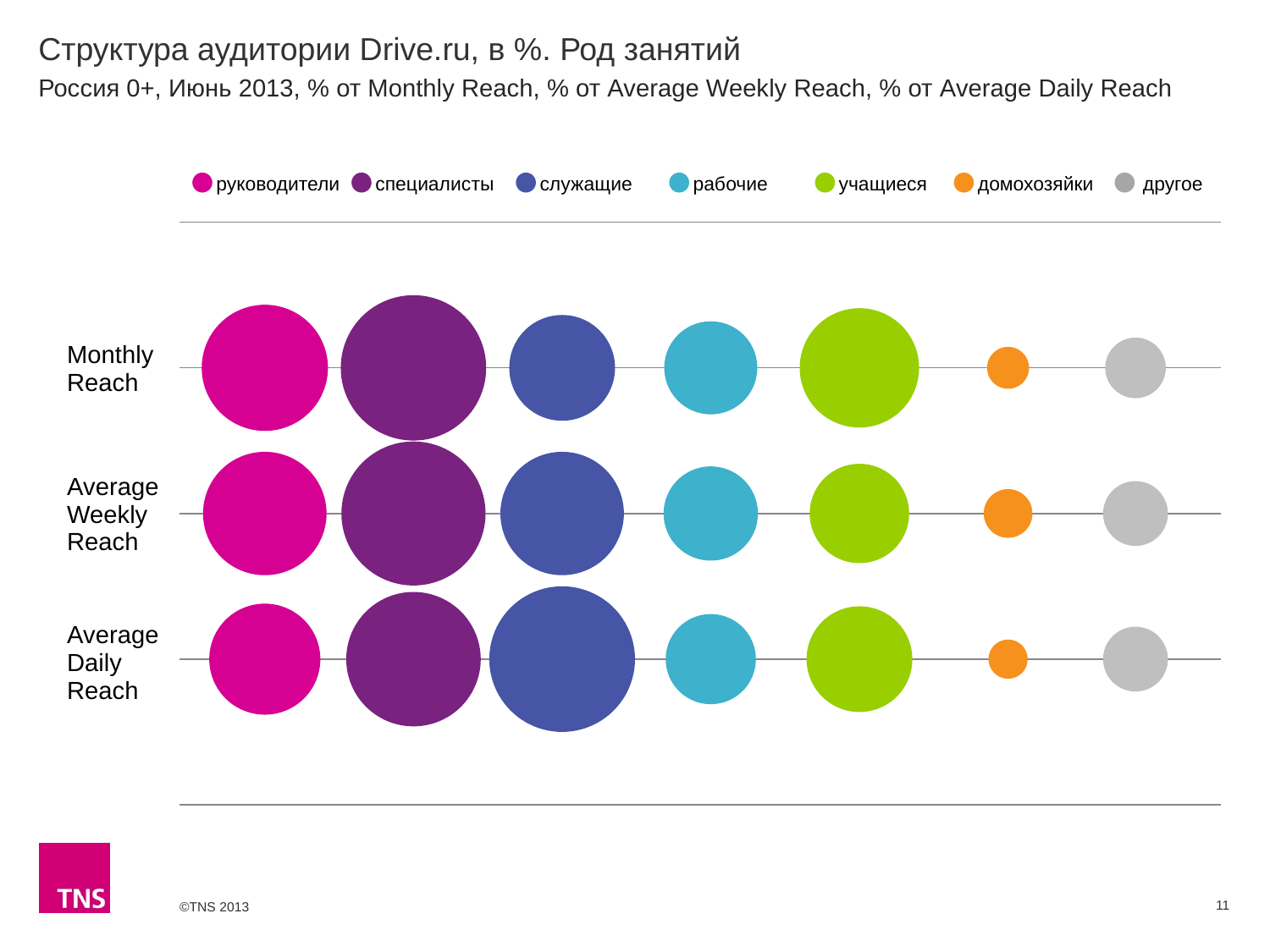
In the Average Daily Reach row, which occupation group has the smallest bubble? домохозяйки In the Monthly Reach row, which occupation group has the smallest bubble? домохозяйки Which legend entry is shown in orange? домохозяйки In the Average Daily Reach row, which occupation group has the largest bubble? служащие In the Monthly Reach row, which bubble is larger: руководители or служащие? руководители How many reach rows (Monthly, Weekly, Daily) are plotted on the chart? 3 What kind of chart is shown on the slide? bubble chart In the Monthly Reach row, which occupation group has the largest bubble? специалисты In the Average Daily Reach row, which bubble is larger: служащие or рабочие? служащие Does the bubble for служащие grow or shrink going from Monthly Reach to Average Daily Reach? grow How many categories does the legend list? 7 In the Average Weekly Reach row, which occupation group has the largest bubble? специалисты